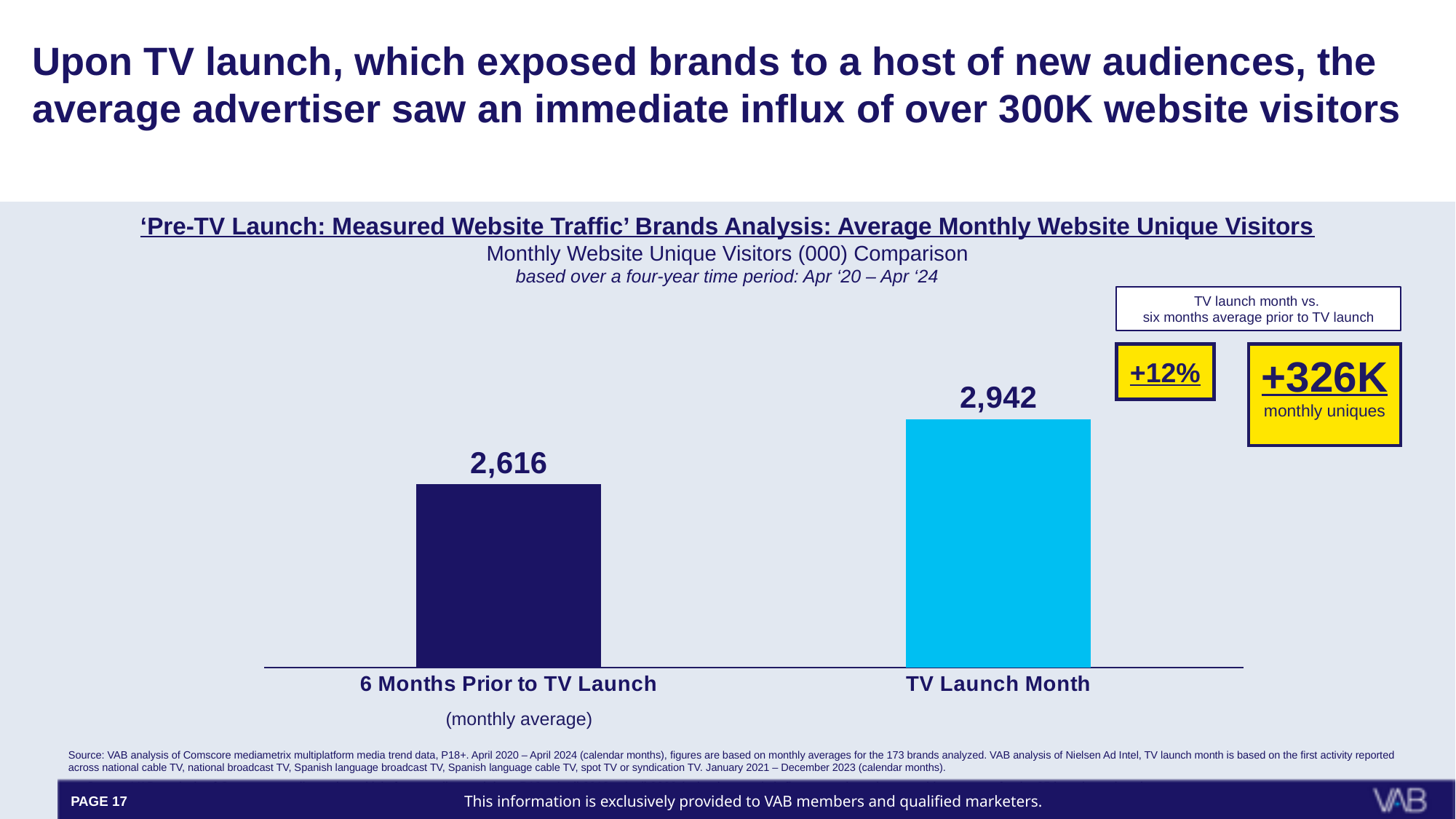
What is the value for TV Launch Month? 2,942 What is the difference between the TV Launch Month value and the 6 Months Prior to TV Launch value? 326 What is the value for 6 Months Prior to TV Launch? 2,616 Which category has the highest value? TV Launch Month What unit are the monthly website unique visitors shown in, according to the chart subtitle? (000) Do the values rise or fall from 6 Months Prior to TV Launch to TV Launch Month? Rise What percentage change is shown in the callout box for TV launch month vs. six months average prior to TV launch? +12% How many categories are shown in the chart? 2 Which category has the lowest value? 6 Months Prior to TV Launch Which is larger, the value for TV Launch Month or the value for 6 Months Prior to TV Launch? TV Launch Month What kind of chart is shown on the slide? Bar chart